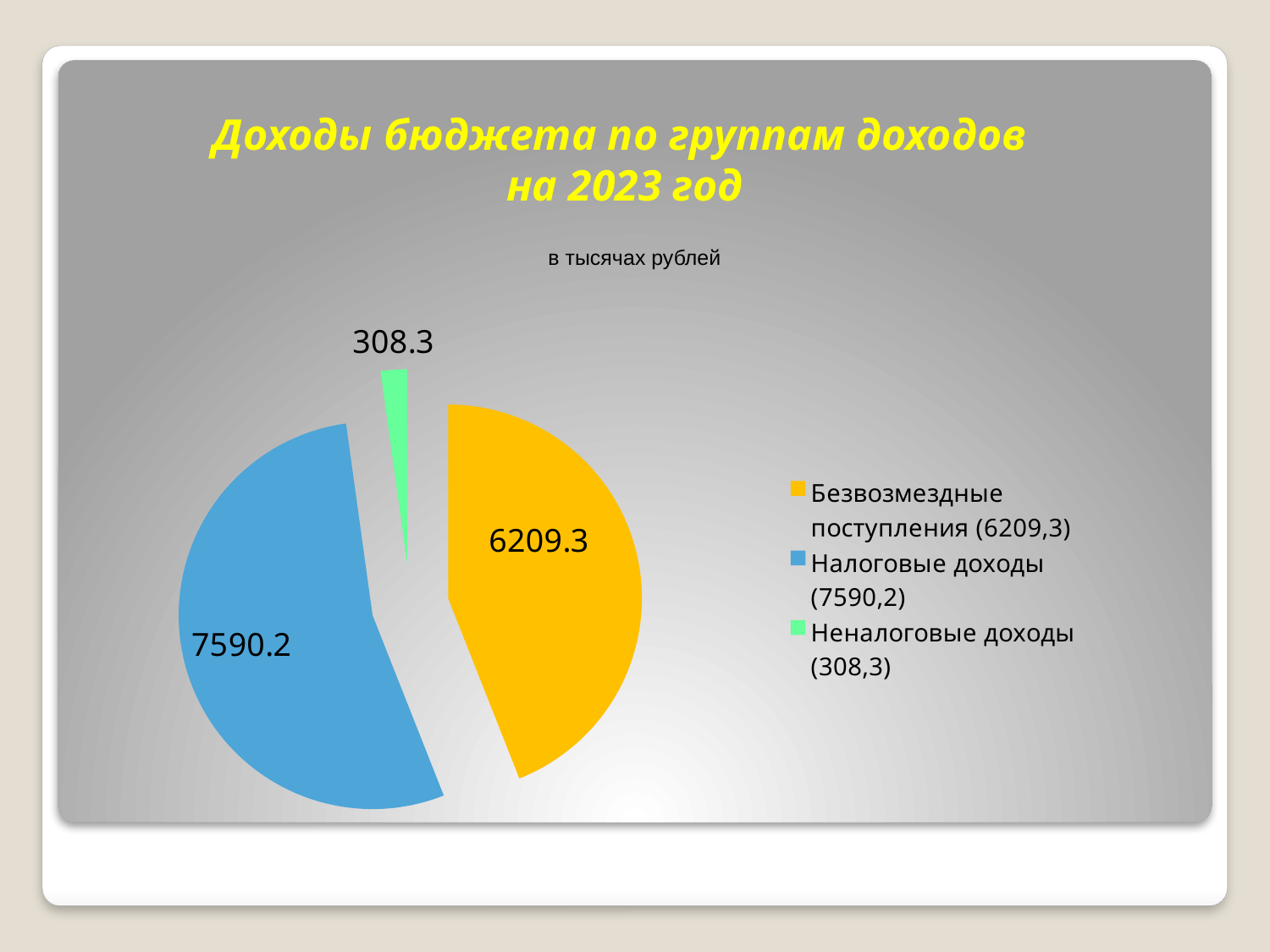
Which income group has the smallest slice of the pie? Неналоговые доходы What is the difference between Налоговые доходы and Безвозмездные поступления? 1380.9 How many slices does the pie chart have? 3 What is the value for Безвозмездные поступления? 6209.3 Which income group has the largest slice of the pie? Налоговые доходы What is the value for Неналоговые доходы? 308.3 Which is larger, Налоговые доходы or Безвозмездные поступления? Налоговые доходы What is the total of all three income groups shown in the pie chart? 14107.8 What unit is stated below the chart title? в тысячах рублей What kind of chart is shown on the slide? Pie chart What is the difference between Безвозмездные поступления and Неналоговые доходы? 5901.0 What is the value for Налоговые доходы? 7590.2